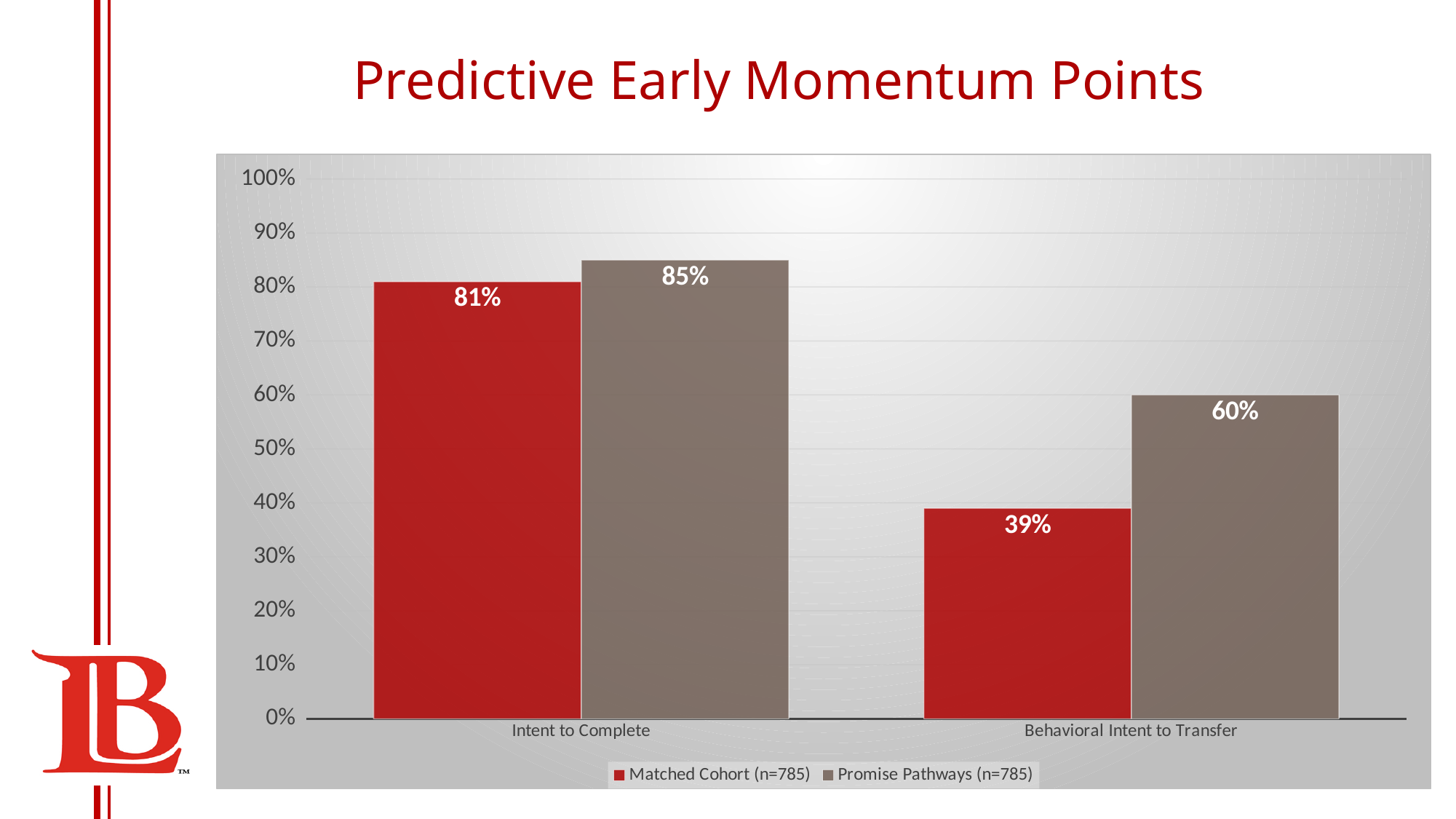
What is the difference between Promise Pathways (n=785) and Matched Cohort (n=785) for Intent to Complete? 4% How many series does the legend list? 2 For Behavioral Intent to Transfer, which series has the larger value, Matched Cohort (n=785) or Promise Pathways (n=785)? Promise Pathways (n=785) What is the value for Promise Pathways (n=785) for Behavioral Intent to Transfer? 60% Which bar has the lowest value on the chart? Matched Cohort (n=785), Behavioral Intent to Transfer Which bar has the highest value on the chart? Promise Pathways (n=785), Intent to Complete What is the value for Matched Cohort (n=785) for Intent to Complete? 81% What is the difference between Promise Pathways (n=785) and Matched Cohort (n=785) for Behavioral Intent to Transfer? 21% How many categories are shown on the x axis? 2 What type of chart is shown on the slide? Bar chart What is the value for Promise Pathways (n=785) for Intent to Complete? 85% What is the value for Matched Cohort (n=785) for Behavioral Intent to Transfer? 39%